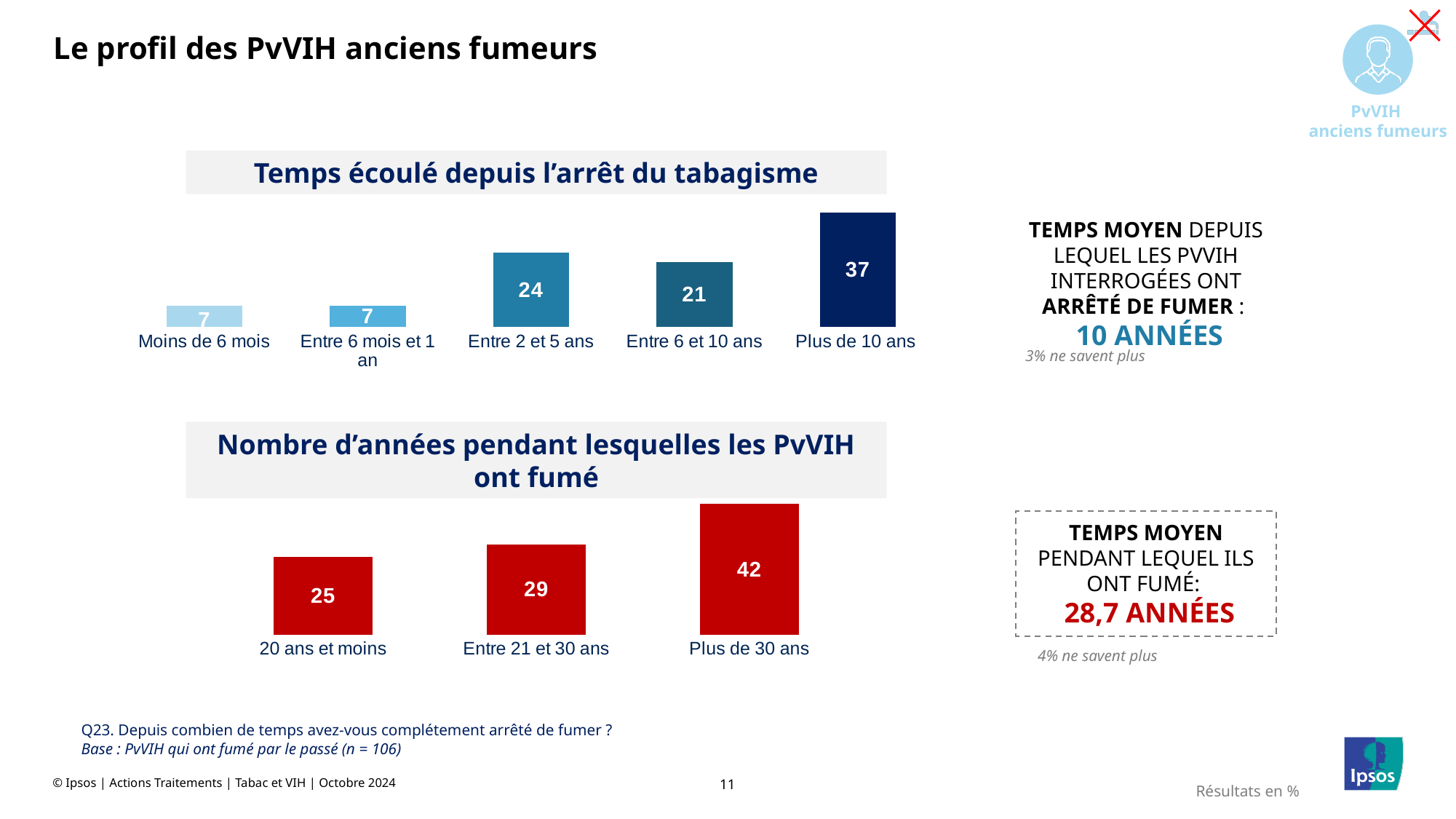
In the chart 'Temps écoulé depuis l'arrêt du tabagisme', what is the difference between 'Entre 2 et 5 ans' and 'Entre 6 et 10 ans'? 3 In the chart 'Temps écoulé depuis l'arrêt du tabagisme', which category has the highest value? Plus de 10 ans In the chart 'Temps écoulé depuis l'arrêt du tabagisme', what is the value for 'Entre 2 et 5 ans'? 24 In the chart 'Temps écoulé depuis l'arrêt du tabagisme', how many categories are shown? 5 In the chart 'Nombre d'années pendant lesquelles les PvVIH ont fumé', what is the difference between 'Plus de 30 ans' and '20 ans et moins'? 17 In the chart 'Nombre d'années pendant lesquelles les PvVIH ont fumé', which category has the lowest value? 20 ans et moins What kind of chart is 'Nombre d'années pendant lesquelles les PvVIH ont fumé'? bar chart In the chart 'Temps écoulé depuis l'arrêt du tabagisme', what is the value for 'Moins de 6 mois'? 7 In the chart 'Nombre d'années pendant lesquelles les PvVIH ont fumé', how many categories are shown? 3 In the chart 'Temps écoulé depuis l'arrêt du tabagisme', what is the value for 'Plus de 10 ans'? 37 In the chart 'Nombre d'années pendant lesquelles les PvVIH ont fumé', do the values rise or fall from left to right? rise In the chart 'Nombre d'années pendant lesquelles les PvVIH ont fumé', what is the value for 'Entre 21 et 30 ans'? 29